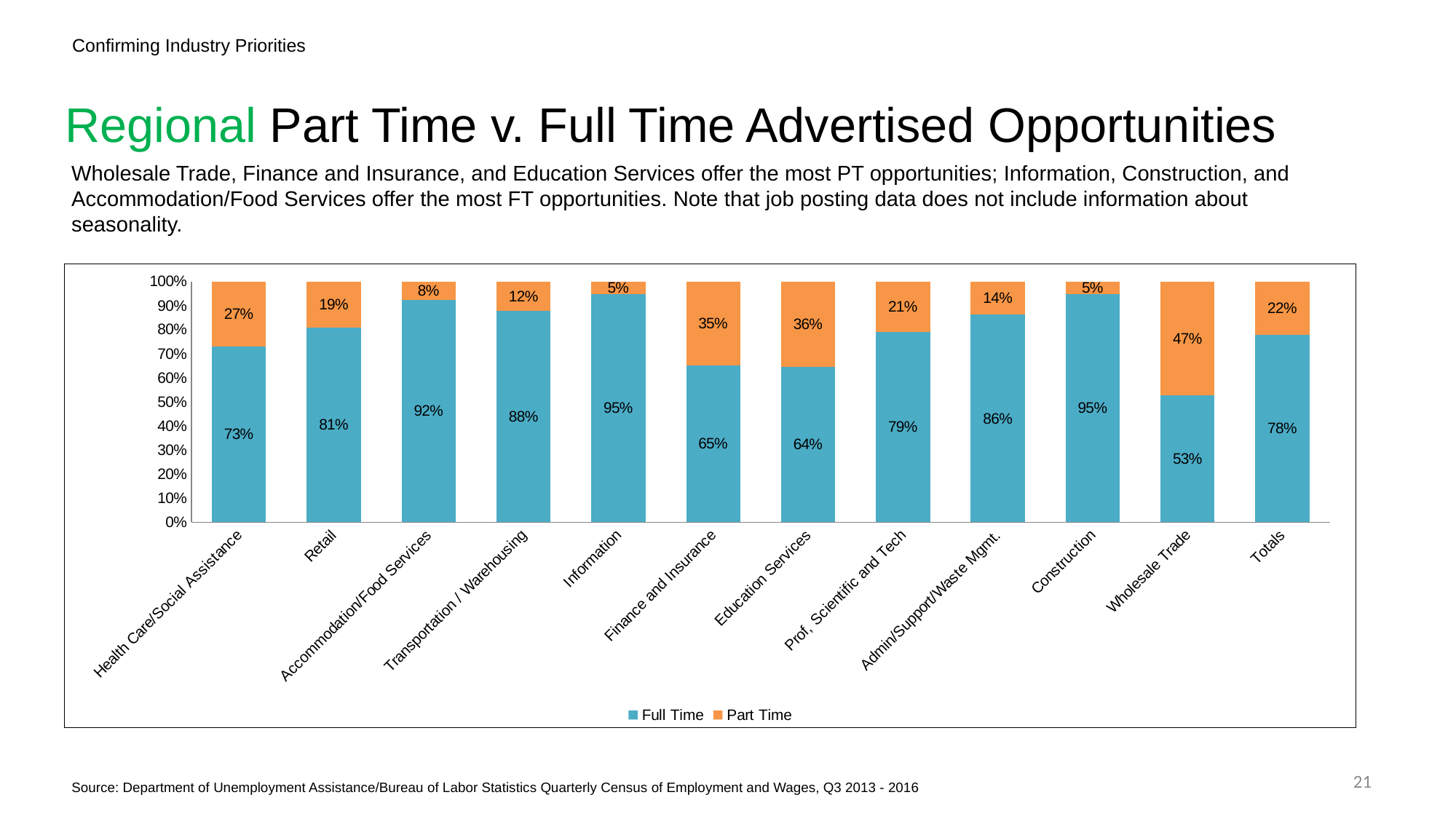
What is the difference between the Full Time percentages for Retail and Education Services? 17% What is the Part Time percentage shown for Totals? 22% What kind of chart is shown on the slide? Stacked bar chart How many categories are shown on the x axis? 12 Which category has the lowest Full Time percentage? Wholesale Trade What is the total of the stacked bar for Admin/Support/Waste Mgmt.? 100% Which has a larger Part Time percentage, Retail or Prof, Scientific and Tech? Prof, Scientific and Tech What is the Part Time percentage for Finance and Insurance? 35% How many series does the legend list? 2 Which category has the highest Part Time percentage? Wholesale Trade What is the Full Time percentage for Health Care/Social Assistance? 73% What is the Full Time percentage for Wholesale Trade? 53%